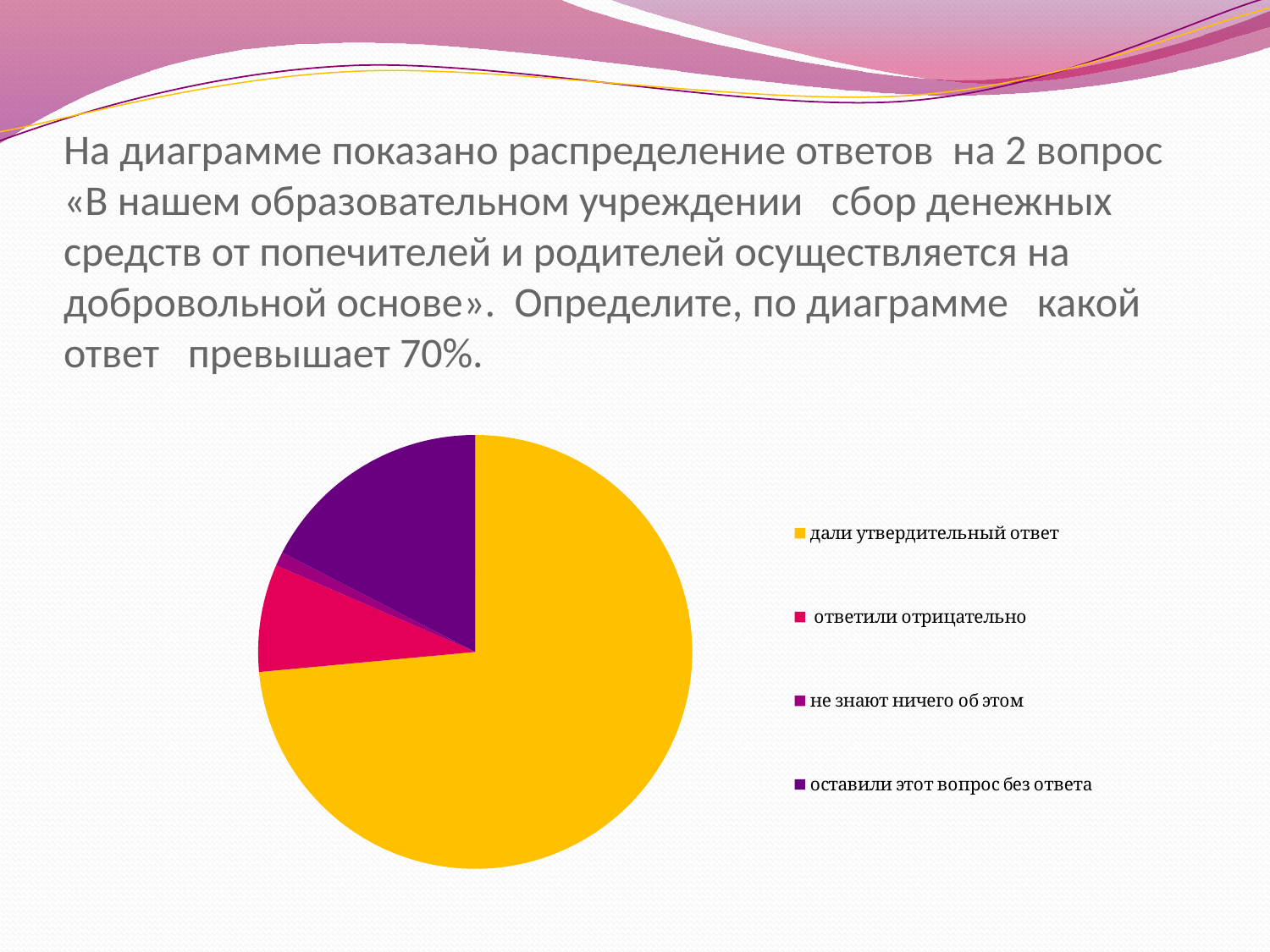
How many entries does the legend of the pie chart list? 4 Which answer category has the largest slice of the pie chart? дали утвердительный ответ What colour is the slice for "дали утвердительный ответ"? yellow Which slice is larger: "не знают ничего об этом" or "ответили отрицательно"? ответили отрицательно What kind of chart is shown on the slide? pie chart Which slice is larger: "ответили отрицательно" or "оставили этот вопрос без ответа"? оставили этот вопрос без ответа According to the slide, which answer category exceeds 70% of responses? дали утвердительный ответ How many slices does the pie chart have? 4 Which answer category has the smallest slice of the pie chart? не знают ничего об этом Which slice is larger: "дали утвердительный ответ" or "оставили этот вопрос без ответа"? дали утвердительный ответ